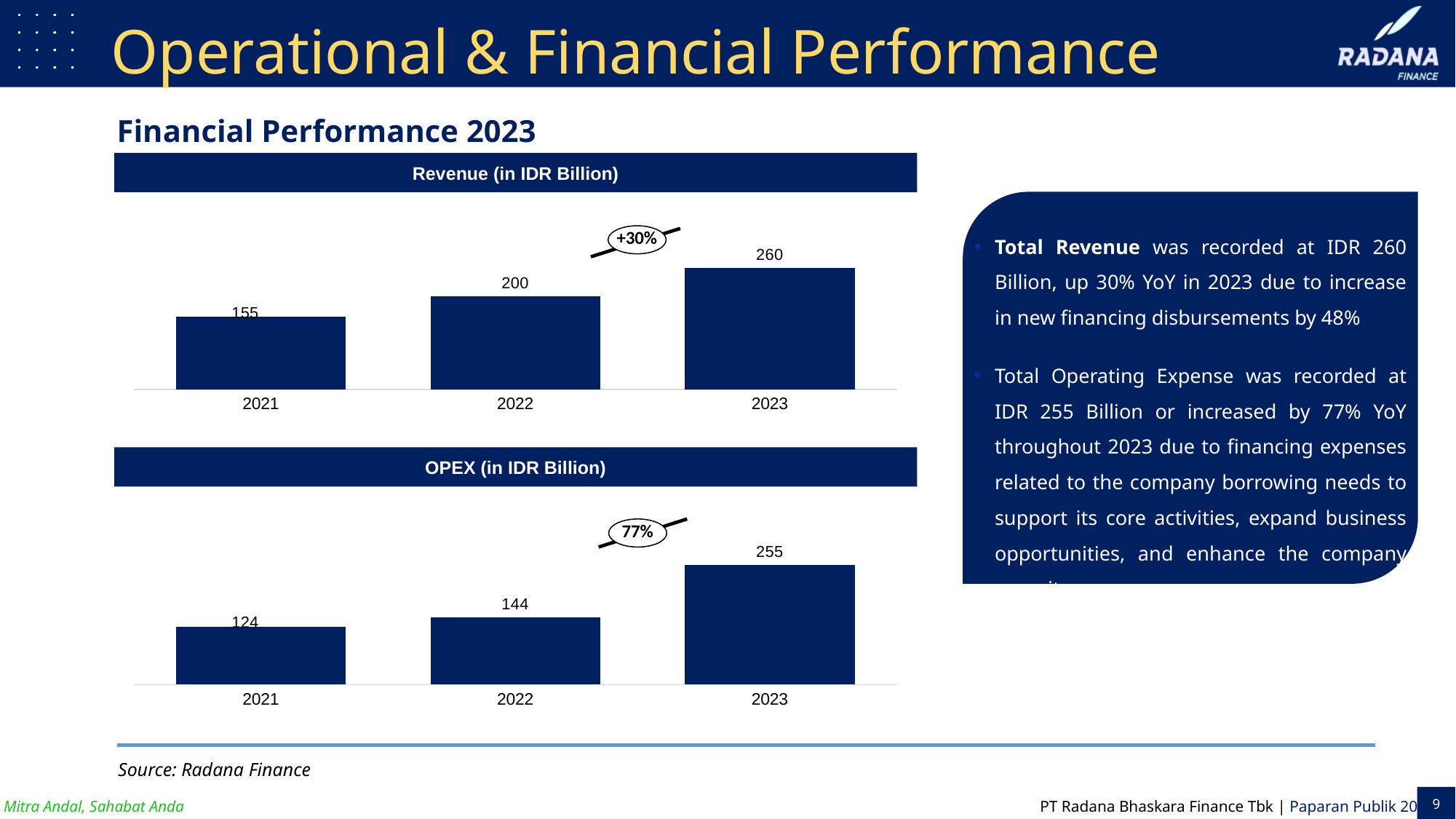
In the Revenue (in IDR Billion) chart, which year has the highest value? 2023 In the Revenue (in IDR Billion) chart, do the values rise or fall from 2021 to 2023? Rise What type of chart is the OPEX (in IDR Billion) chart? Bar chart In the Revenue (in IDR Billion) chart, what is the value for 2023? 260 In the Revenue (in IDR Billion) chart, what is the difference between the 2023 and 2022 values? 60 In the OPEX (in IDR Billion) chart, what is the difference between the 2023 and 2021 values? 131 In the OPEX (in IDR Billion) chart, what is the value for 2023? 255 How many years are shown in the Revenue (in IDR Billion) chart? 3 In the OPEX (in IDR Billion) chart, what is the value for 2022? 144 In the Revenue (in IDR Billion) chart, what is the value for 2021? 155 In the OPEX (in IDR Billion) chart, which year has the lowest value? 2021 In the OPEX (in IDR Billion) chart, which is larger, the value for 2021 or the value for 2022? 2022